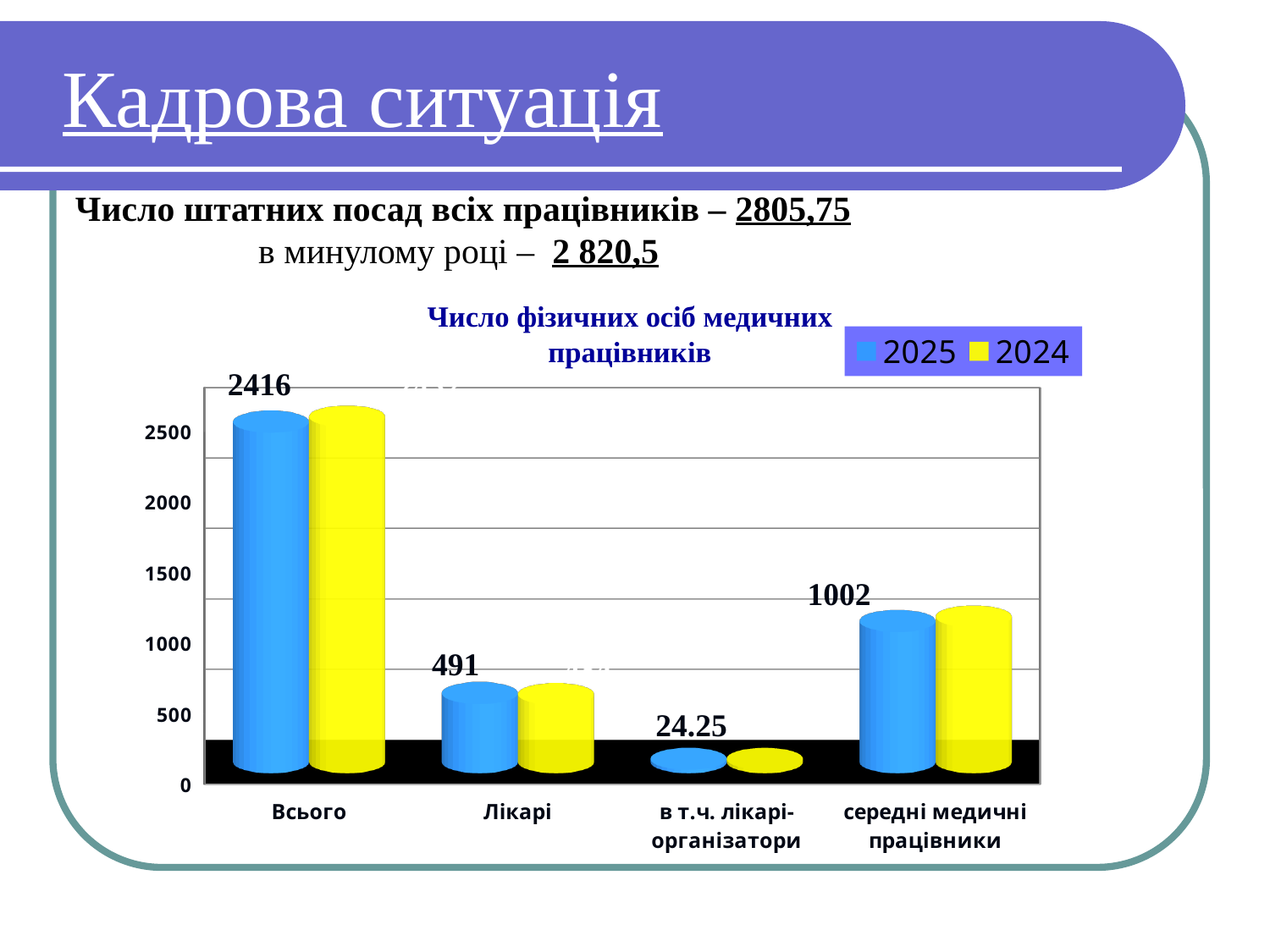
Which category has the highest 2025 value? Всього How many categories are shown on the x axis of the chart? 4 What is the difference between the 2025 values for середні медичні працівники and Лікарі? 511 Is the 2024 value for Всього greater or less than 2000? greater What colour represents the 2024 series in the chart? Yellow What is the 2025 value for Лікарі? 491 Which category has the lowest 2025 value? в т.ч. лікарі-організатори Which is larger in 2025: Лікарі or середні медичні працівники? середні медичні працівники What is the 2025 value for Всього in the chart 'Число фізичних осіб медичних працівників'? 2416 What is the 2025 value for середні медичні працівники? 1002 What is the 2025 value for в т.ч. лікарі-організатори? 24.25 How many series does the legend list? 2